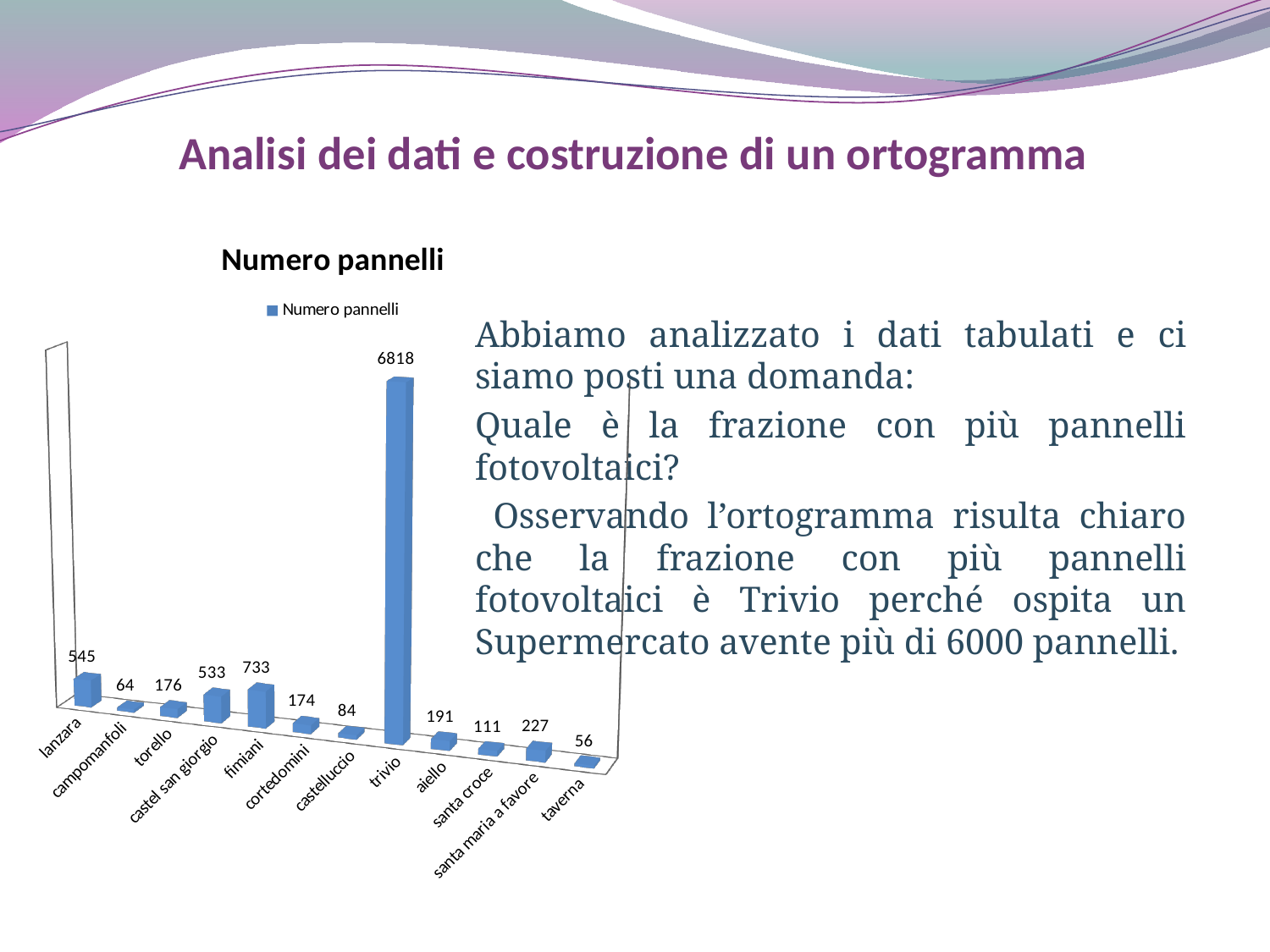
What is the value for fimiani? 733 What kind of chart is shown? bar chart How many categories are shown on the x axis? 12 How many series does the legend list? 1 Which is larger, the value for aiello or the value for santa croce? aiello What is the value for santa maria a favore? 227 What is the value for trivio? 6818 Which is larger, the value for torello or the value for cortedomini? torello What is the difference between the values for fimiani and castel san giorgio? 200 What is the difference between the values for lanzara and campomanfoli? 481 Which category has the highest value? trivio Which category has the lowest value? taverna